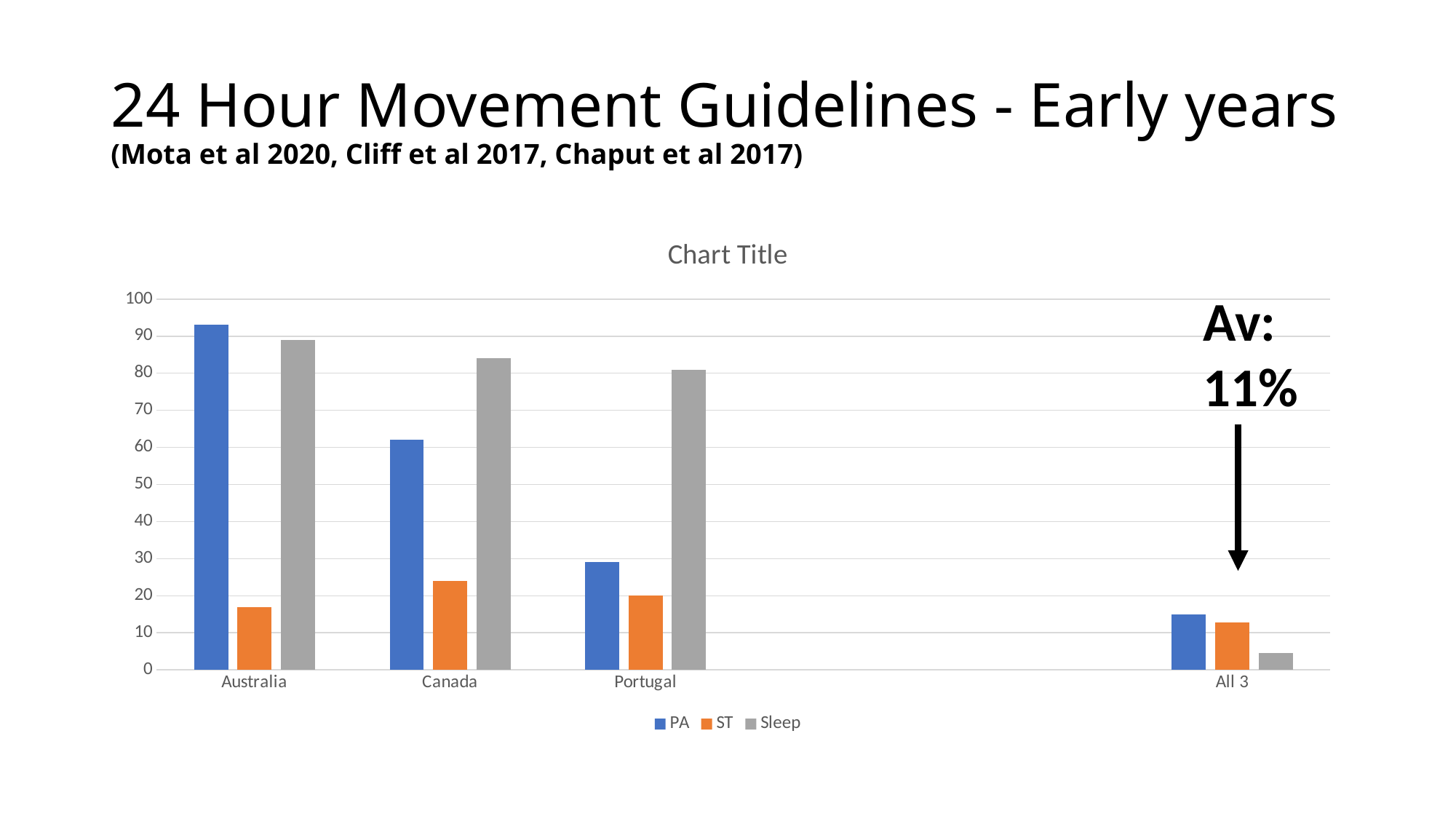
What average percentage is written in the annotation above the All 3 bars? 11% Do the PA values rise or fall moving from Australia to All 3 along the x axis? fall Which category has the lowest Sleep value? All 3 For Canada, which is larger, the Sleep value or the PA value? Sleep Which category has the highest PA value? Australia Is the PA value for Canada greater or less than 50? greater Is the PA value for Australia greater or less than 90? greater How many series does the legend list? 3 How many categories are shown on the x axis? 4 Is the ST value for Australia greater or less than 20? less What kind of chart is shown on the slide? bar chart